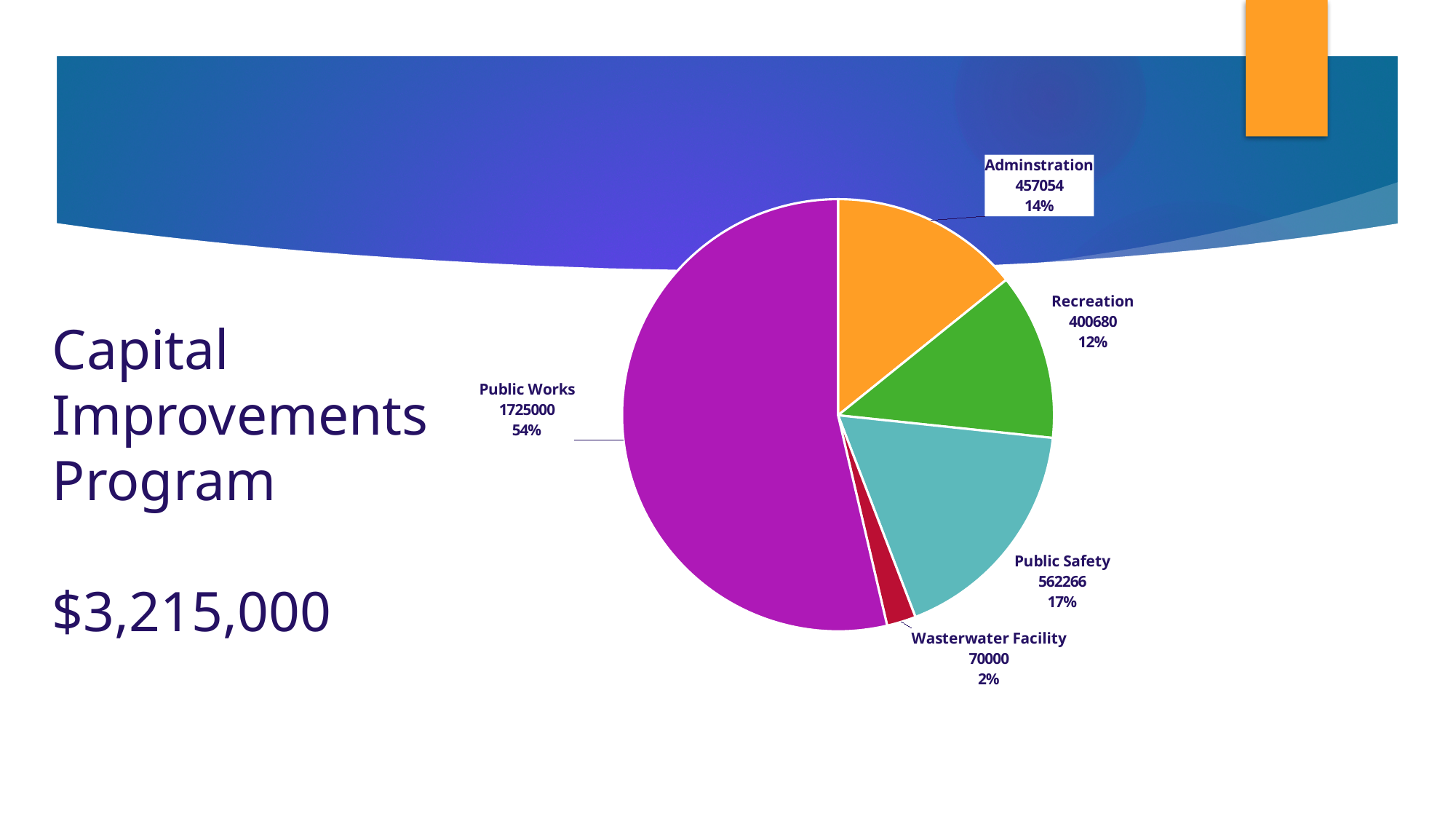
What share of the pie does Public Works represent? 54% What is the value for Public Safety? 562266 How many categories are shown in the pie chart? 5 Which category has the smallest slice? Wasterwater Facility What is the value for Wasterwater Facility? 70000 Which category has the largest slice? Public Works What is the difference between the values for Public Safety and Recreation? 161586 What kind of chart is shown on the slide? pie chart What is the value for Public Works? 1725000 What is the value for Recreation? 400680 Which is larger, the value for Adminstration or the value for Recreation? Adminstration What share of the pie does Adminstration represent? 14%